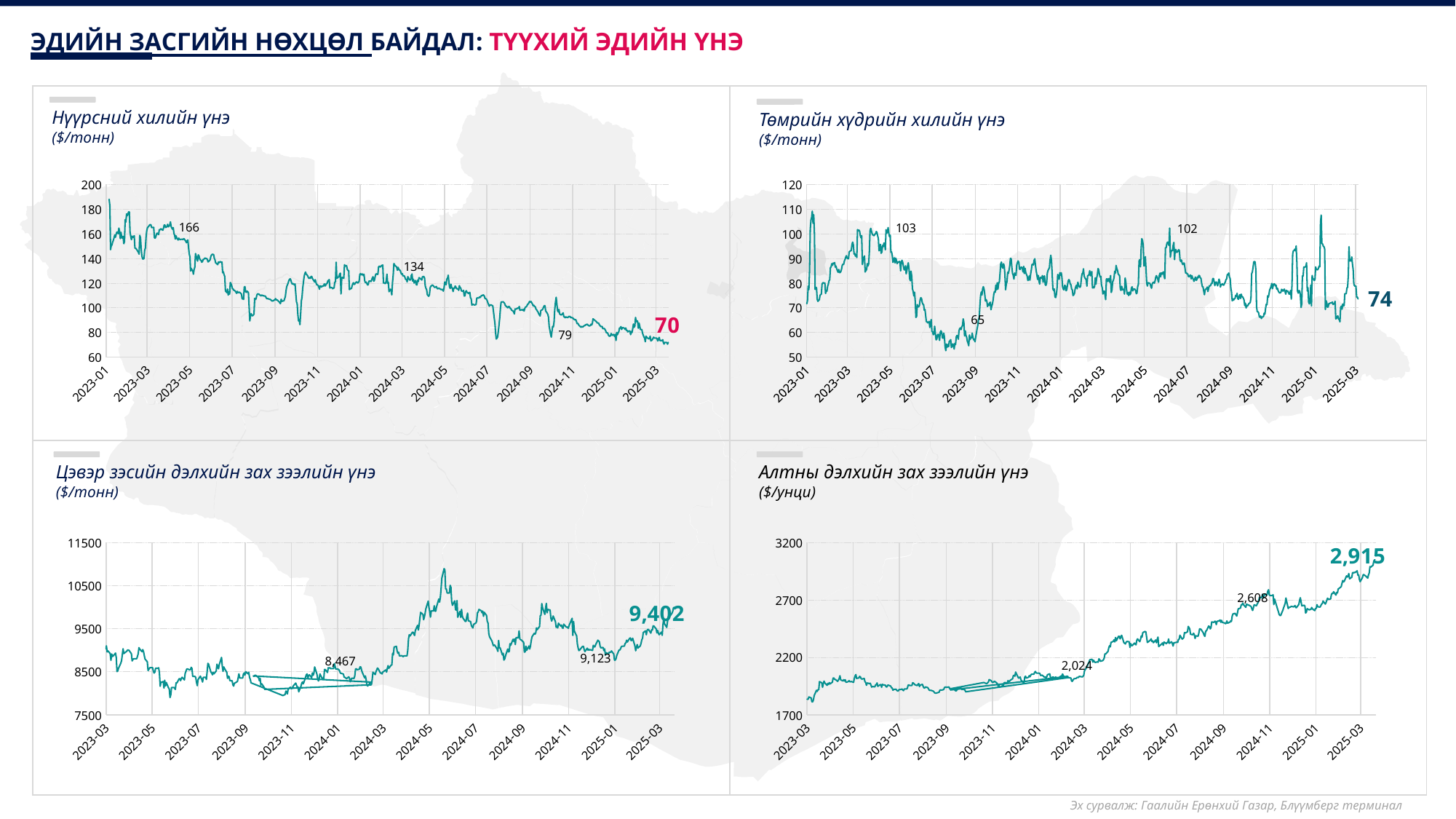
On the iron ore chart (top right), which labelled value is larger: 103 or 65? 103 What unit is shown under the title of the gold chart (bottom right)? $/унци On the iron ore border price chart (top right), what is the latest value shown at the end of the line? 74 On the gold world market price chart (bottom right), what is the latest value shown at the end of the line? 2,915 On the coal chart (top left), what is the difference between the labelled values 166 and 134? 32 On the copper world market price chart (bottom left), what is the latest value shown at the end of the line? 9,402 What kind of chart is used for the gold world market price (bottom right)? line chart On the gold chart (bottom right), do the values generally rise or fall from 2023-03 to 2025-03? rise On the coal chart (top left), do the values generally rise or fall from 2023-01 to 2025-03? fall On the copper chart (bottom left), is the peak value around 2024-05 greater or less than 10,500? greater On the gold chart (bottom right), what is the difference between the latest value 2,915 and the labelled value 2,608? 307 On the coal border price chart (top left), what is the latest value shown at the end of the line? 70